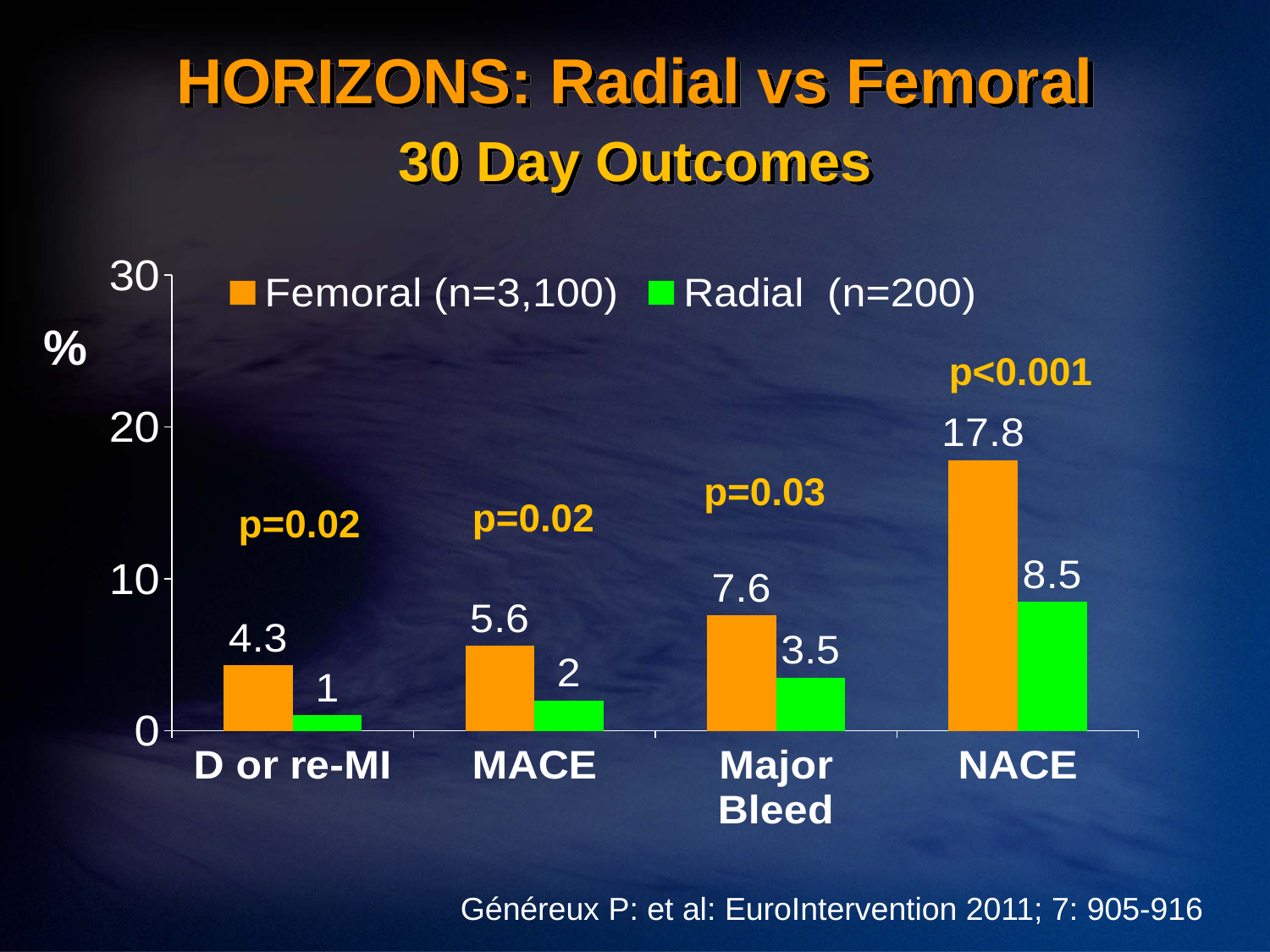
What is the difference between the Femoral and Radial values for MACE? 3.6 What is the Radial value for D or re-MI? 1 Which category has the highest Femoral value? NACE Which category has the lowest Radial value? D or re-MI Which is larger, the Femoral value for Major Bleed or the Radial value for NACE? Radial value for NACE What kind of chart is shown on the slide? Bar chart How many categories are shown on the x axis? 4 What p-value is shown above the NACE bars? p<0.001 What is the Radial value for Major Bleed? 3.5 What is the Femoral value for NACE? 17.8 How many series does the legend list? 2 What is the difference between the Femoral and Radial values for NACE? 9.3